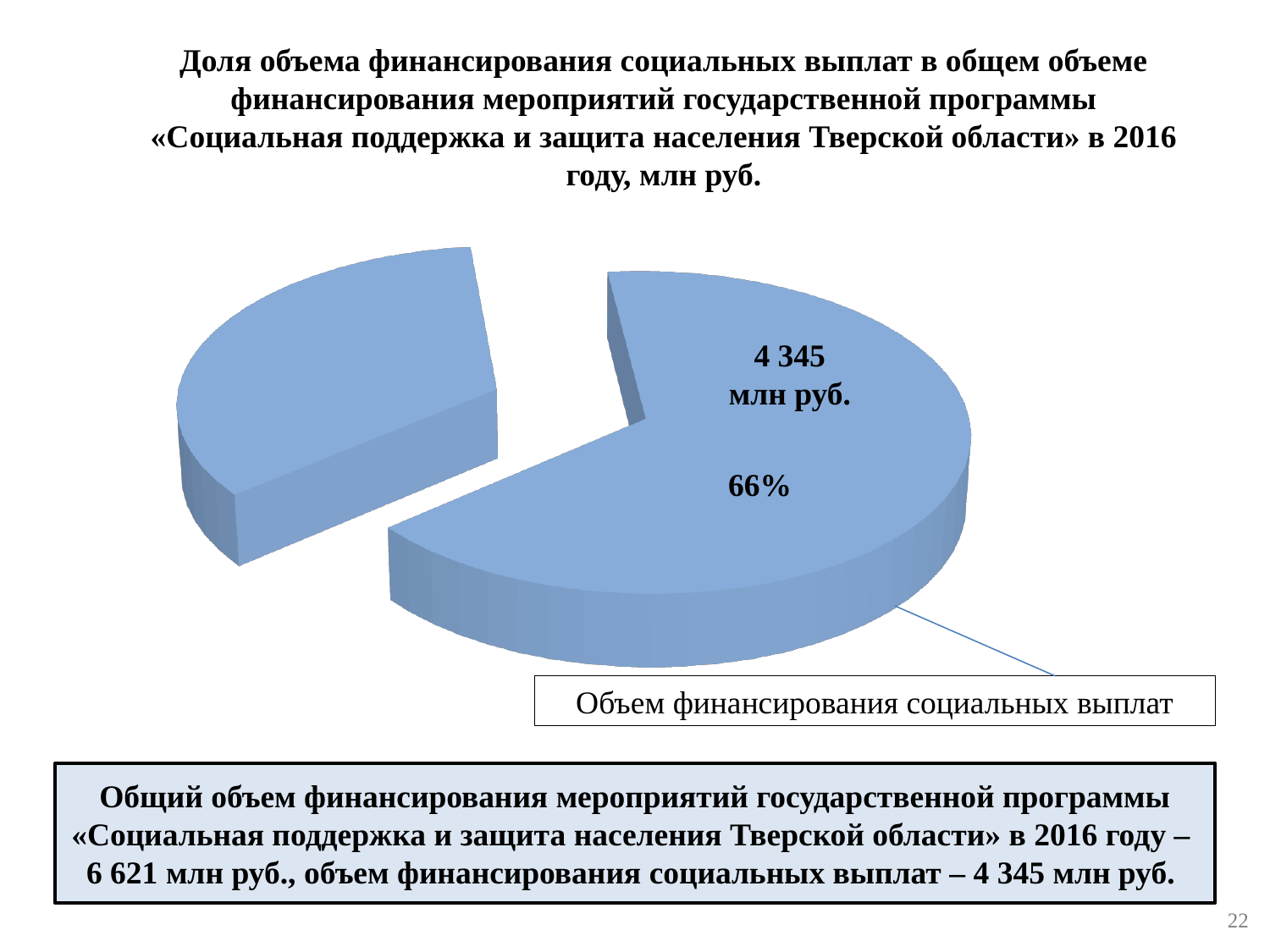
Which slice of the pie is the largest? Объем финансирования социальных выплат What kind of chart is shown on the slide? pie chart How many slices does the pie chart have? 2 What share of the pie does the slice «Объем финансирования социальных выплат» represent? 66% According to the text box below the chart, what is the total funding volume of the programme in 2016? 6 621 млн руб. Which slice is larger: the one labelled «Объем финансирования социальных выплат» or the unlabelled slice? Объем финансирования социальных выплат In what year are the data in the chart reported, according to the chart title? 2016 What unit of measurement is stated in the chart title? млн руб. Is the share of the slice «Объем финансирования социальных выплат» greater or less than 50%? greater What value is printed on the slice labelled «Объем финансирования социальных выплат»? 4 345 млн руб.